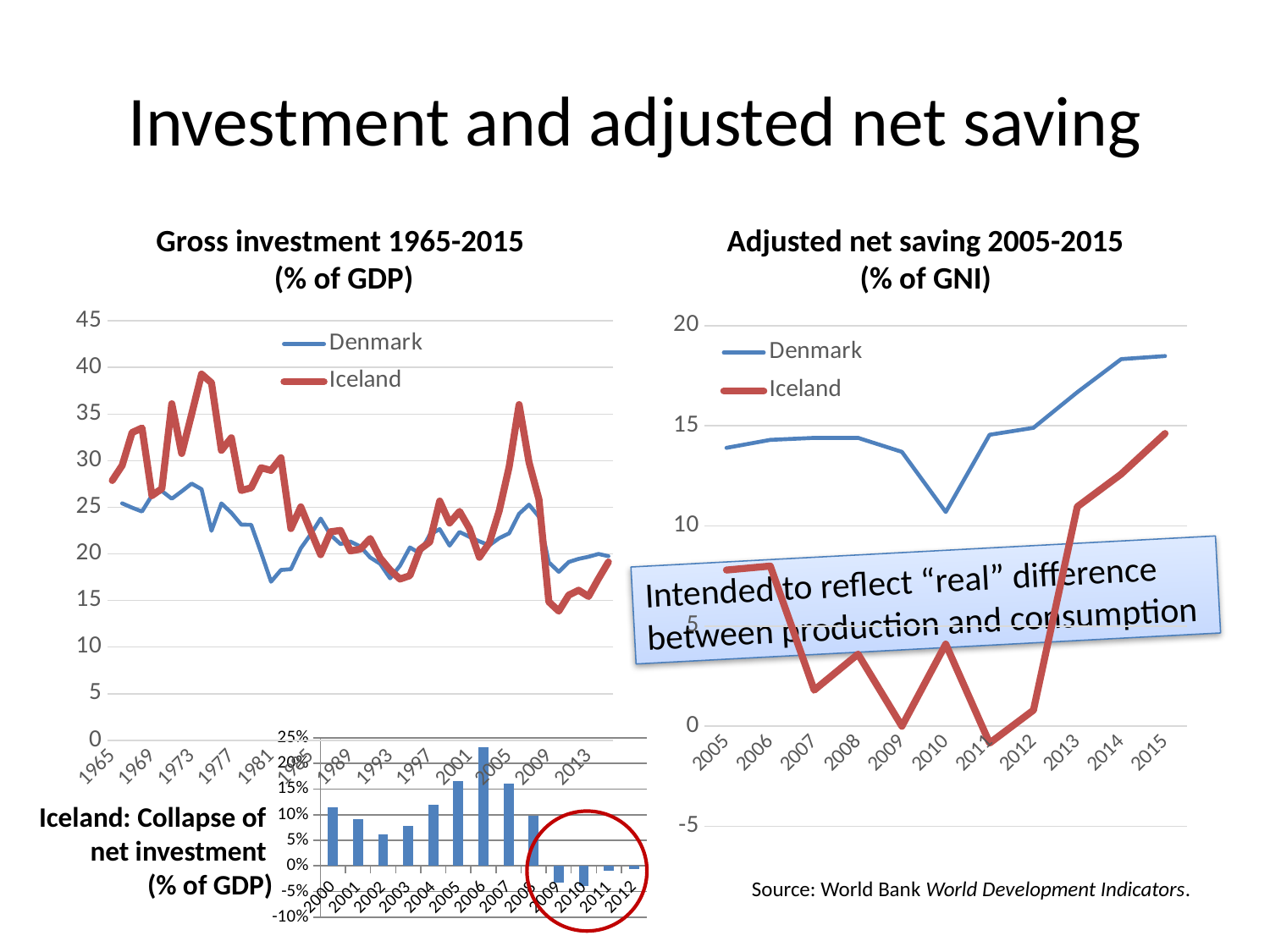
In the 'Gross investment 1965-2015 (% of GDP)' chart, is Iceland's peak value in the mid-1970s greater or less than 35? greater In the 'Iceland: Collapse of net investment (% of GDP)' bar chart, which year has the highest value? 2006 In the 'Adjusted net saving 2005-2015 (% of GNI)' chart, which series has the higher value in 2010? Denmark In the 'Gross investment 1965-2015 (% of GDP)' chart, is Denmark's value in 1981 greater or less than 20? less How many series does the legend of the 'Adjusted net saving 2005-2015 (% of GNI)' chart list? 2 In the 'Adjusted net saving 2005-2015 (% of GNI)' chart, does Denmark's value rise or fall from 2011 to 2015? rise In the 'Gross investment 1965-2015 (% of GDP)' chart, which series reaches the highest value over the whole period? Iceland In the 'Adjusted net saving 2005-2015 (% of GNI)' chart, in which year does Iceland reach its lowest value? 2011 In the 'Adjusted net saving 2005-2015 (% of GNI)' chart, is Denmark's value in 2015 greater or less than 15? greater How many years are shown on the x axis of the 'Iceland: Collapse of net investment (% of GDP)' bar chart? 13 What kind of chart is the 'Gross investment 1965-2015 (% of GDP)' chart? line chart What kind of chart is the 'Iceland: Collapse of net investment (% of GDP)' chart at the bottom of the slide? bar chart